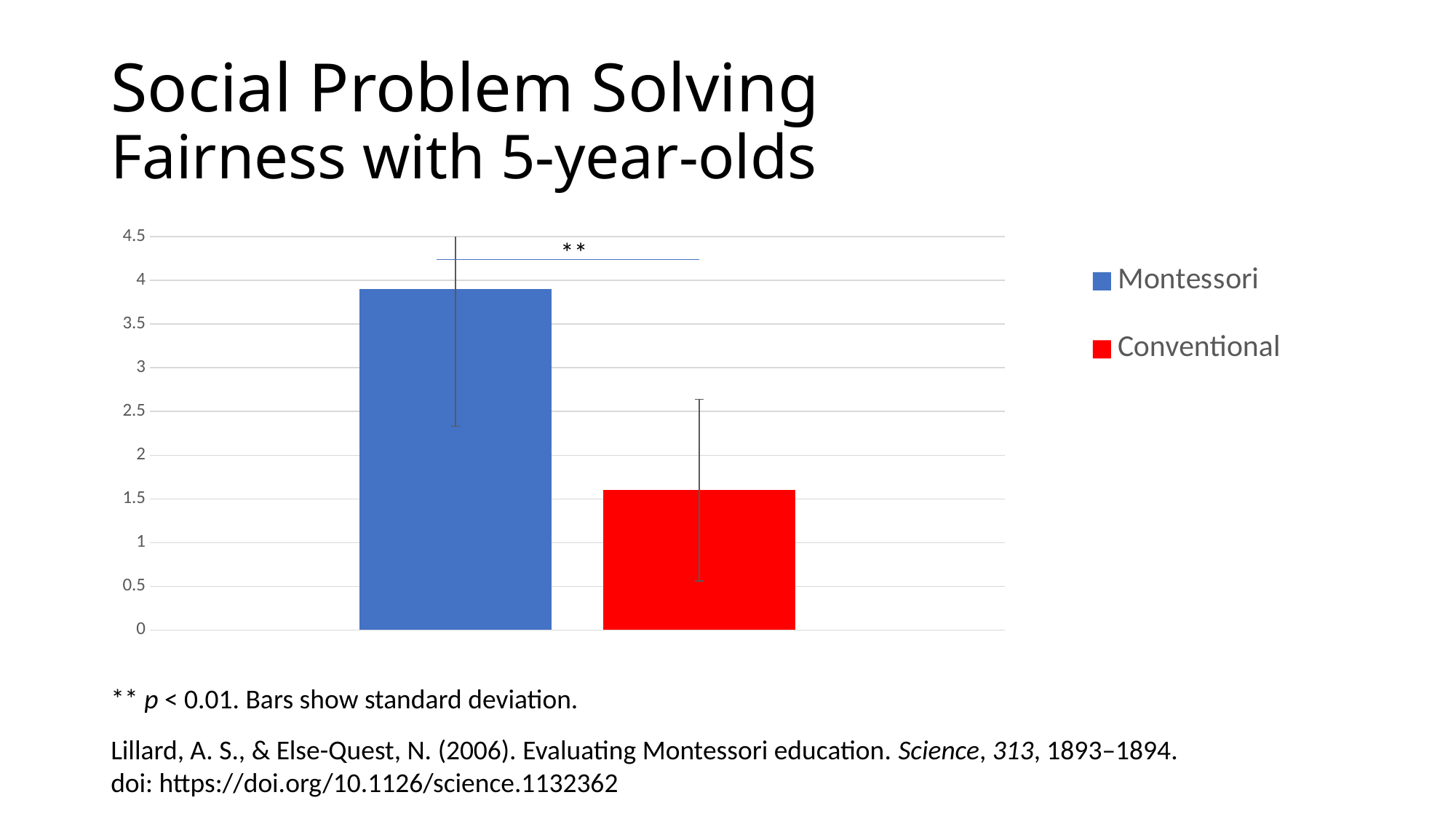
What colour is the Conventional bar in the chart? red Which group has the lowest bar in the chart? Conventional Is the value for Montessori larger or smaller than the value for Conventional? larger Is the value for Montessori greater or less than 3.5? greater Is the value for Conventional greater or less than 1? greater According to the note below the chart, what do the error bars show? standard deviation How many bars are plotted in the chart? 2 Is the value for Montessori greater or less than 3? greater How many series does the legend list? 2 Which group has the higher bar, Montessori or Conventional? Montessori What kind of chart is shown on the slide? bar chart